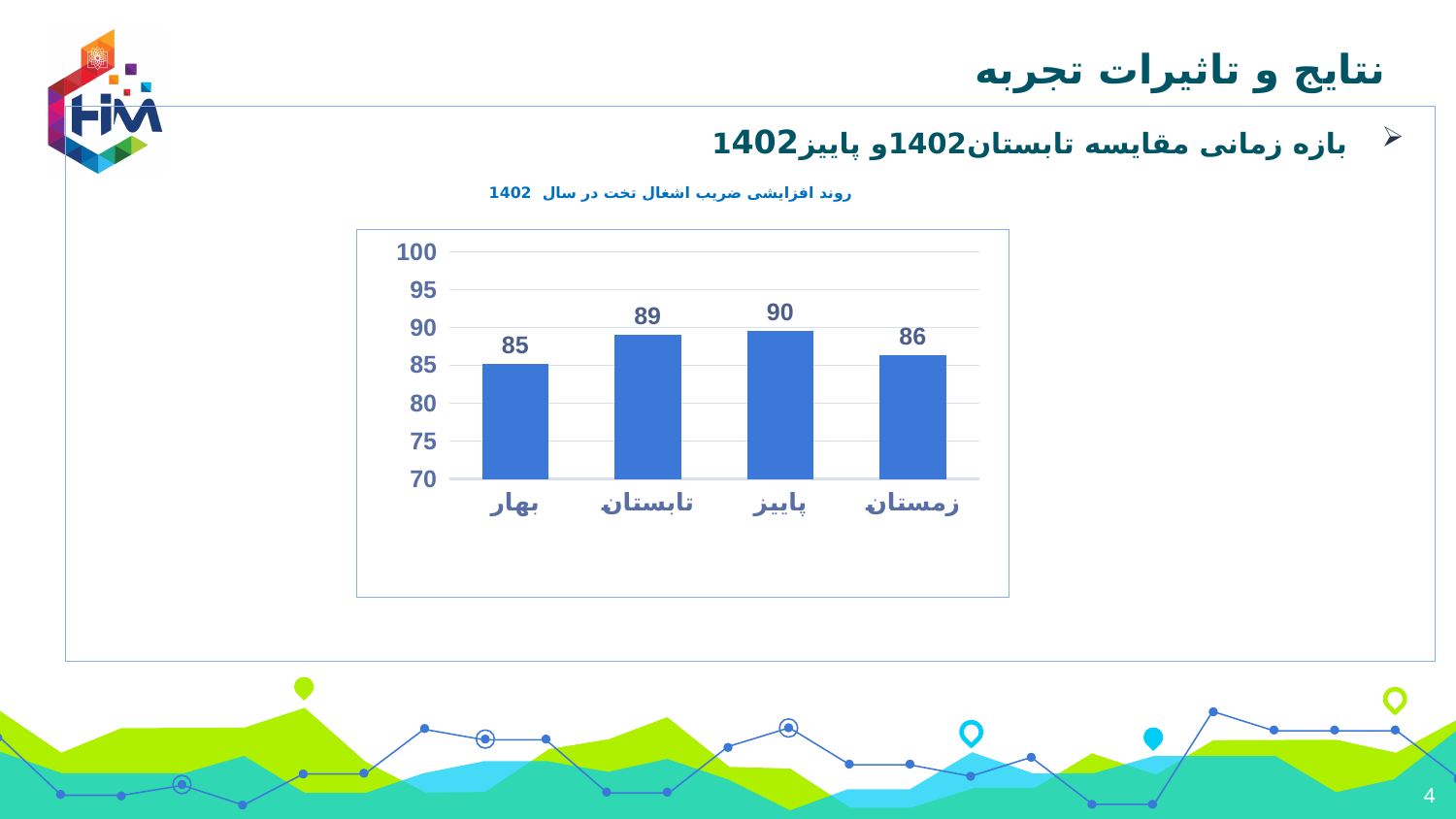
What is the value for پاییز? 90 What is the difference between the values for پاییز and بهار? 5 Which category has the highest value? پاییز Which category has the lowest value? بهار Is the value for زمستان greater or less than 90? less What is the value for بهار? 85 Which is larger, the value for تابستان or the value for زمستان? تابستان What is the value for زمستان? 86 What kind of chart is shown on the slide? bar chart What is the value for تابستان? 89 What is the title of the chart? روند افزایشی ضریب اشغال تخت در سال 1402 How many categories are shown on the x axis? 4